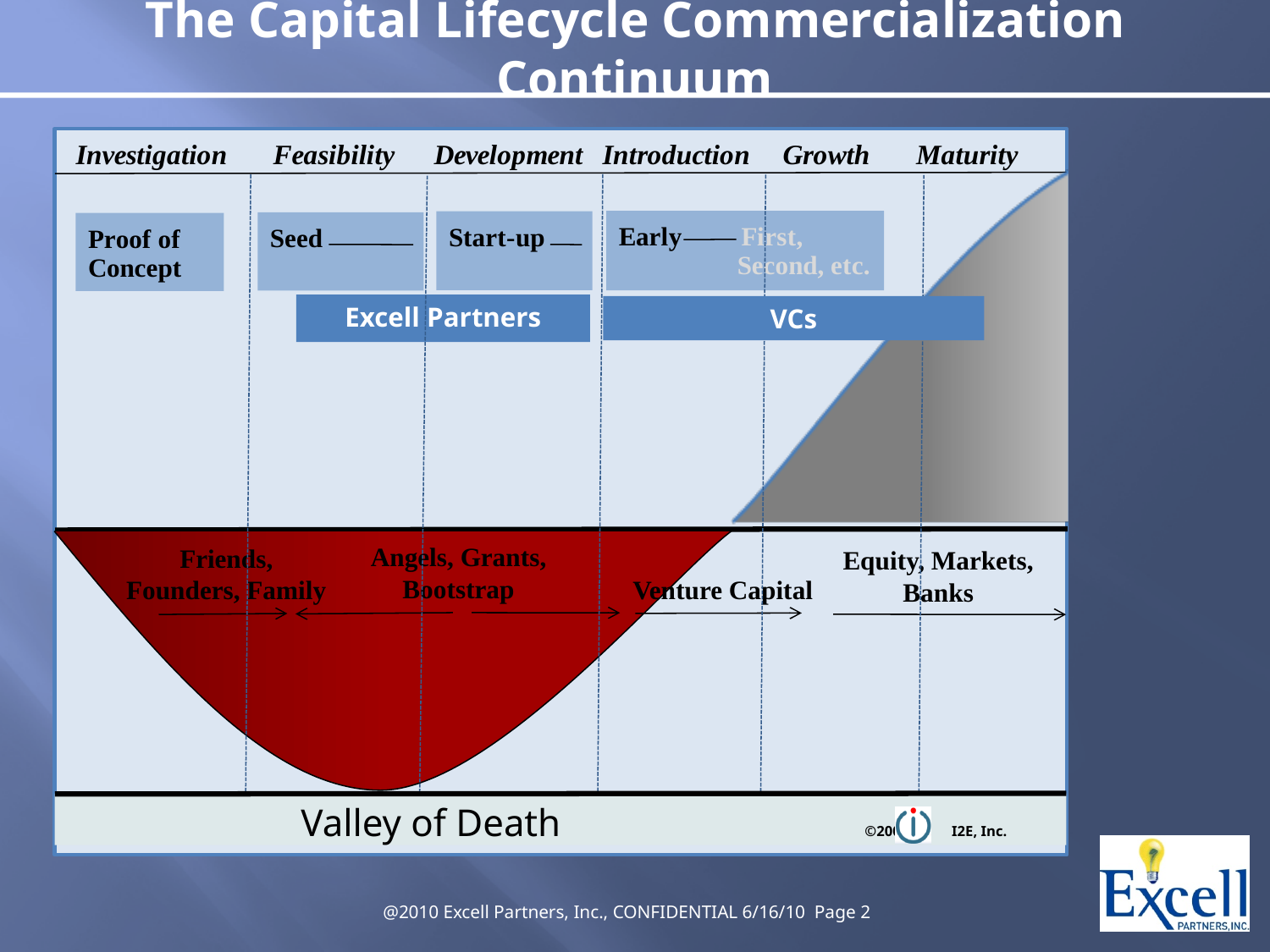
What is the title of the slide? The Capital Lifecycle Commercialization Continuum Which funding sources are labeled under the Investigation stage in the lower section of the diagram? Friends, Founders, Family Which lifecycle stage is listed first (leftmost) across the top of the diagram? Investigation Which funding source bar spans the Introduction and Growth stages? VCs How many lifecycle stages are labeled across the top of the diagram? 6 Does the grey curve rise or fall as it moves from the Introduction stage toward the Maturity stage? rise What label appears in the band at the bottom of the diagram beneath the red curve? Valley of Death Which funding sources are labeled under the Growth and Maturity stages in the lower section of the diagram? Equity, Markets, Banks Which lifecycle stage is listed last (rightmost) across the top of the diagram? Maturity Which funding source bar spans the Feasibility and Development stages? Excell Partners Which funding source is labeled under the Introduction stage in the lower section of the diagram? Venture Capital